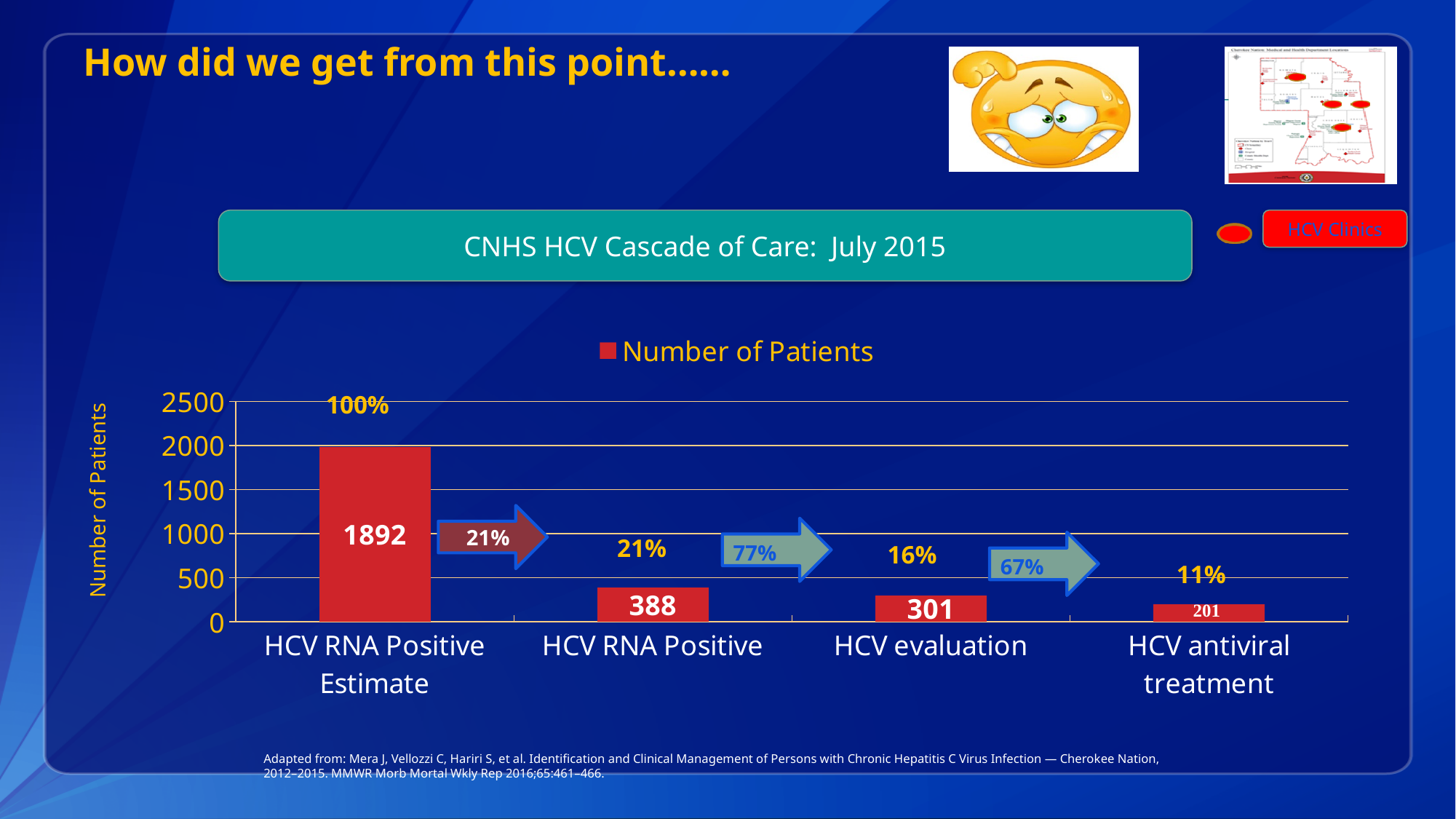
Which has more patients, HCV evaluation or HCV antiviral treatment? HCV evaluation Which category has the lowest number of patients? HCV antiviral treatment What kind of chart is shown on the slide? Bar chart How many categories are shown on the x axis? 4 What is the number of patients for HCV RNA Positive? 388 What is the number of patients for HCV evaluation? 301 What is the difference in number of patients between HCV RNA Positive Estimate and HCV antiviral treatment? 1691 Which category has the highest number of patients? HCV RNA Positive Estimate What is the number of patients for HCV antiviral treatment? 201 What is the number of patients for HCV RNA Positive Estimate? 1892 Do the values rise or fall from left to right along the x axis? Fall What is the difference in number of patients between HCV RNA Positive and HCV evaluation? 87